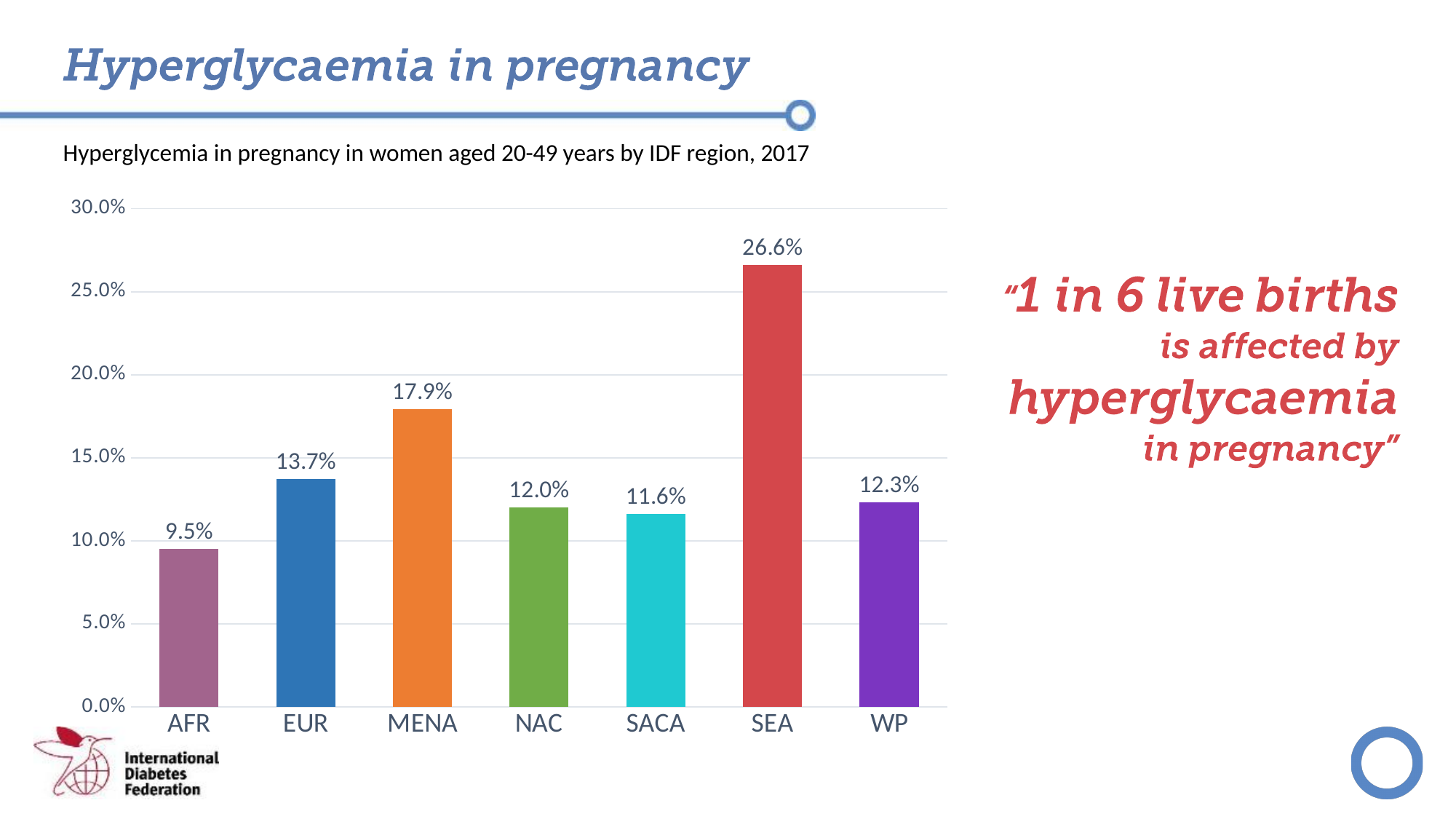
What kind of chart is shown on the slide? bar chart What is the title of the chart? Hyperglycemia in pregnancy in women aged 20-49 years by IDF region, 2017 What is the difference between the values for MENA and EUR? 4.2% What is the value for MENA? 17.9% Which region has the lowest value? AFR What is the value for AFR? 9.5% Is the value for EUR greater or less than 15.0%? less What is the difference between the values for SEA and AFR? 17.1% What is the value for SEA? 26.6% Which region has the highest value? SEA How many regions are shown on the x axis? 7 Which is larger, the value for WP or the value for SACA? WP